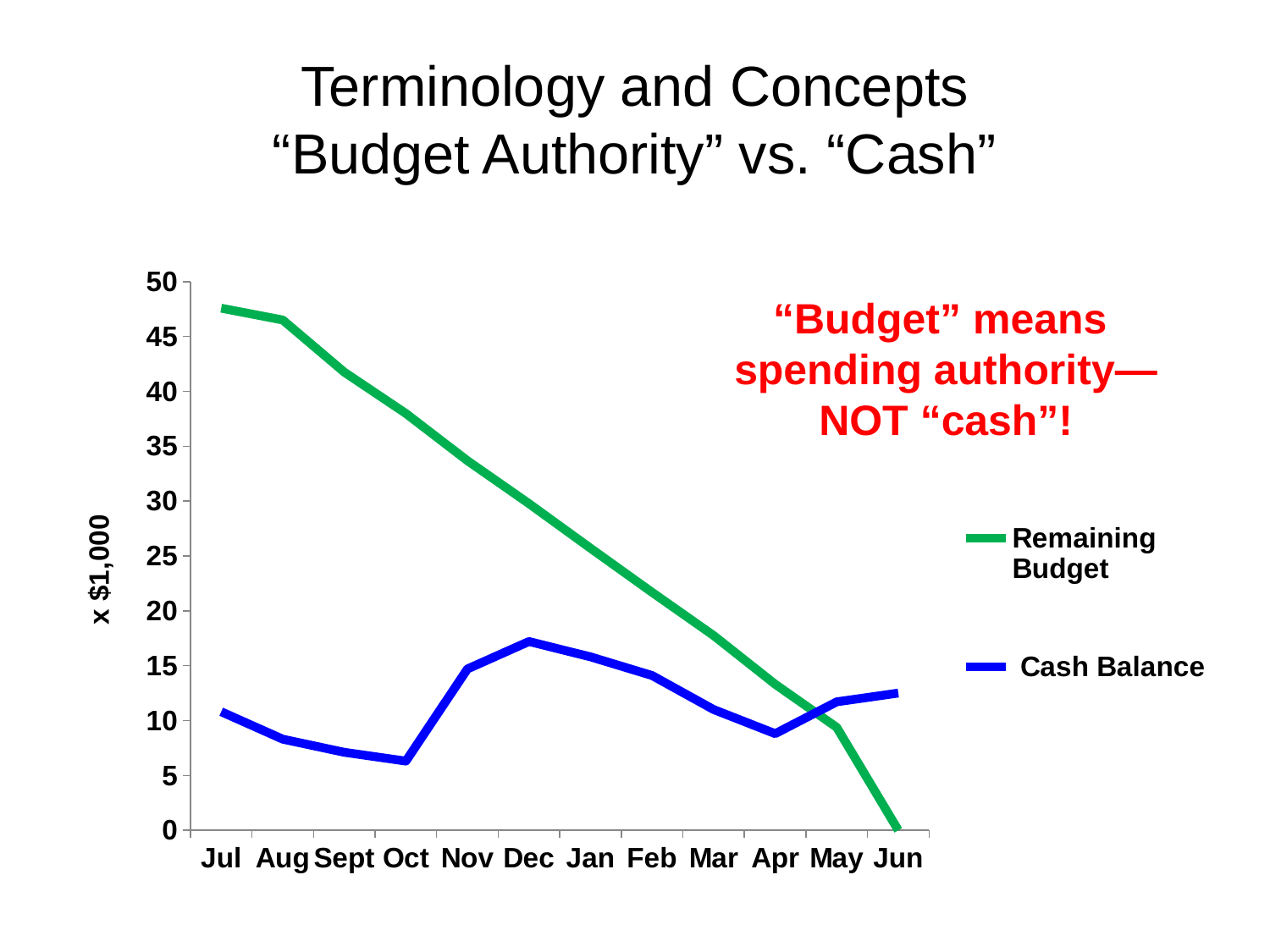
What is the label on the y axis? x $1,000 What is the Remaining Budget value in Jun? 0 How many series does the legend list? 2 In which month is the Cash Balance highest? Dec Is the Cash Balance value for Oct greater or less than 10? less Is the Remaining Budget value for Jul greater or less than 45? greater How many months are shown along the x axis? 12 What kind of chart is shown on the slide? line chart Is the Cash Balance value for Dec greater or less than 15? greater In which month is the Cash Balance lowest? Oct Does the Remaining Budget line rise or fall from Jul to Jun? fall In Jun, which series has the larger value, Remaining Budget or Cash Balance? Cash Balance